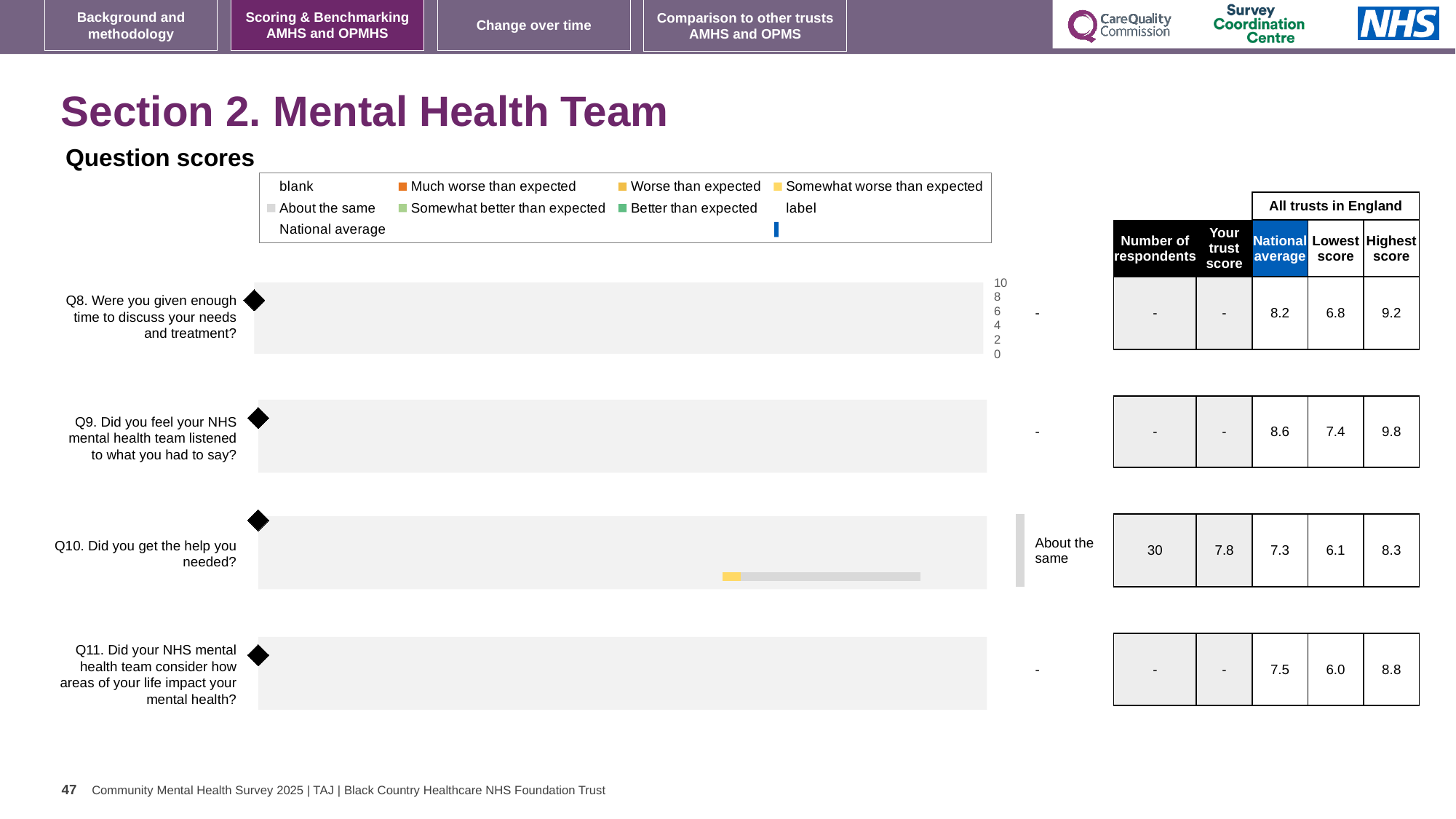
What is the benchmark category shown for Q10? About the same What is the difference between the trust score and the national average for Q10? 0.5 How many questions (categories) are shown in the question scores chart? 4 What kind of chart is used to display the question scores on this slide? bar chart What is the highest score among all trusts in England for Q8? 9.2 How many respondents are recorded for Q10? 30 Which question is the only one with a plotted bar in the question scores chart? Q10. Did you get the help you needed? Is the trust score for Q10 larger or smaller than the national average for Q10? larger What is the trust score for Q10 (Did you get the help you needed?)? 7.8 Which question has the highest national average? Q9. Did you feel your NHS mental health team listened to what you had to say? What is the national average for Q10 (Did you get the help you needed?)? 7.3 Which question has the lowest national average? Q11. Did your NHS mental health team consider how areas of your life impact your mental health?